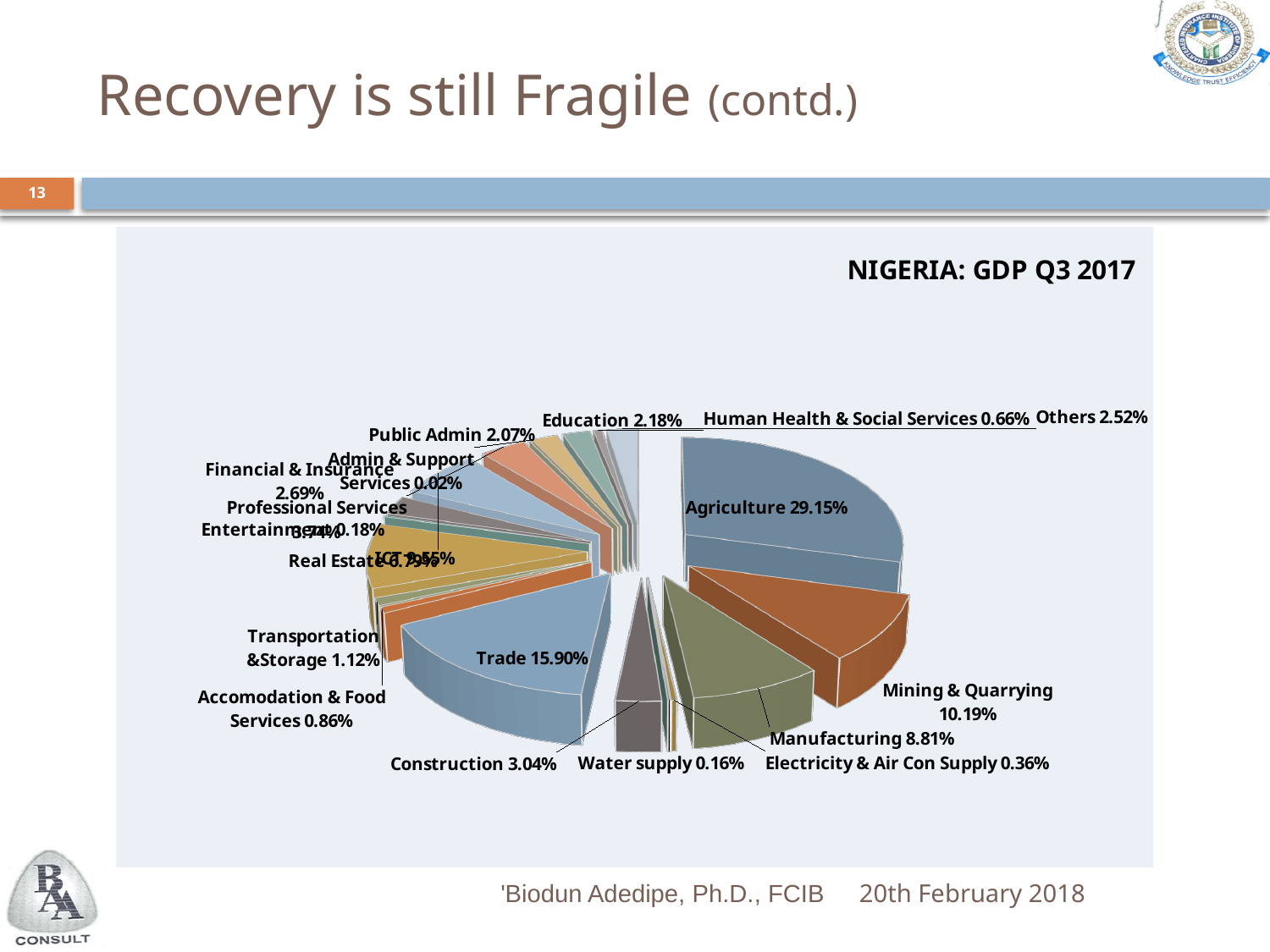
What is the value shown for Trade? 15.90% Which is larger, the share for Trade or the share for Mining & Quarrying? Trade Which sector has the largest share of the pie? Agriculture What is the title of the chart? NIGERIA: GDP Q3 2017 What is the value shown for Construction? 3.04% What kind of chart is shown on the slide? pie chart Which sector has the smallest share of the pie? Admin & Support Services What is the value shown for Manufacturing? 8.81% What is the difference between the shares of Agriculture and Trade? 13.25% What is the value shown for Mining & Quarrying? 10.19% What is the value shown for Education? 2.18% What share of GDP does Agriculture account for? 29.15%